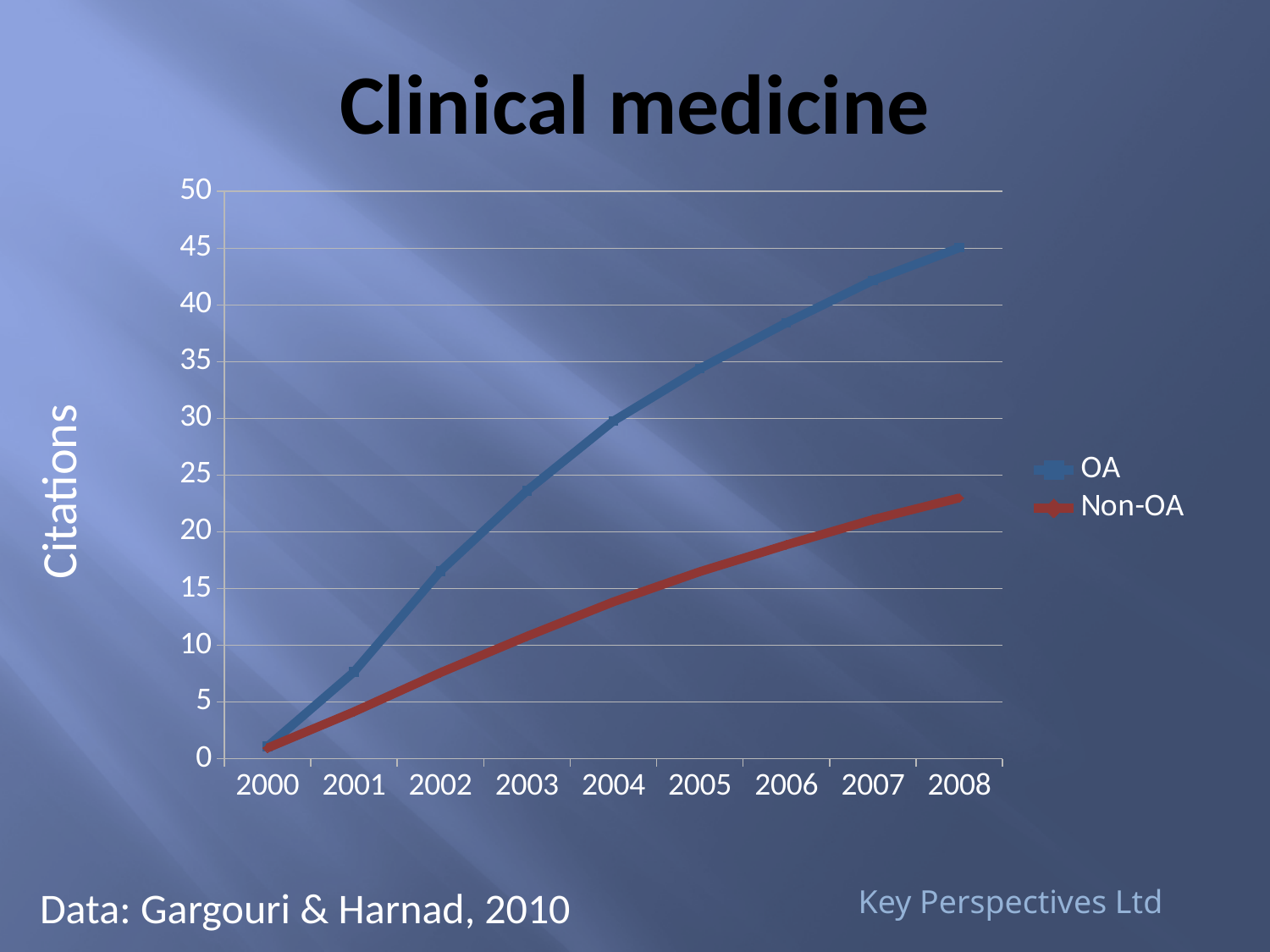
How many years are shown on the x axis? 9 In which year does the OA series reach its highest value? 2008 What is the title of the chart? Clinical medicine Is the Non-OA value for 2008 greater or less than 25? less Is the OA value for 2004 greater or less than 20? greater Is the Non-OA value for 2004 greater or less than 20? less What is the label on the y axis? Citations How many series does the legend list? 2 What kind of chart is shown on the slide? line chart In 2008, which series has more citations, OA or Non-OA? OA Do the OA citations rise or fall from 2000 to 2008? rise